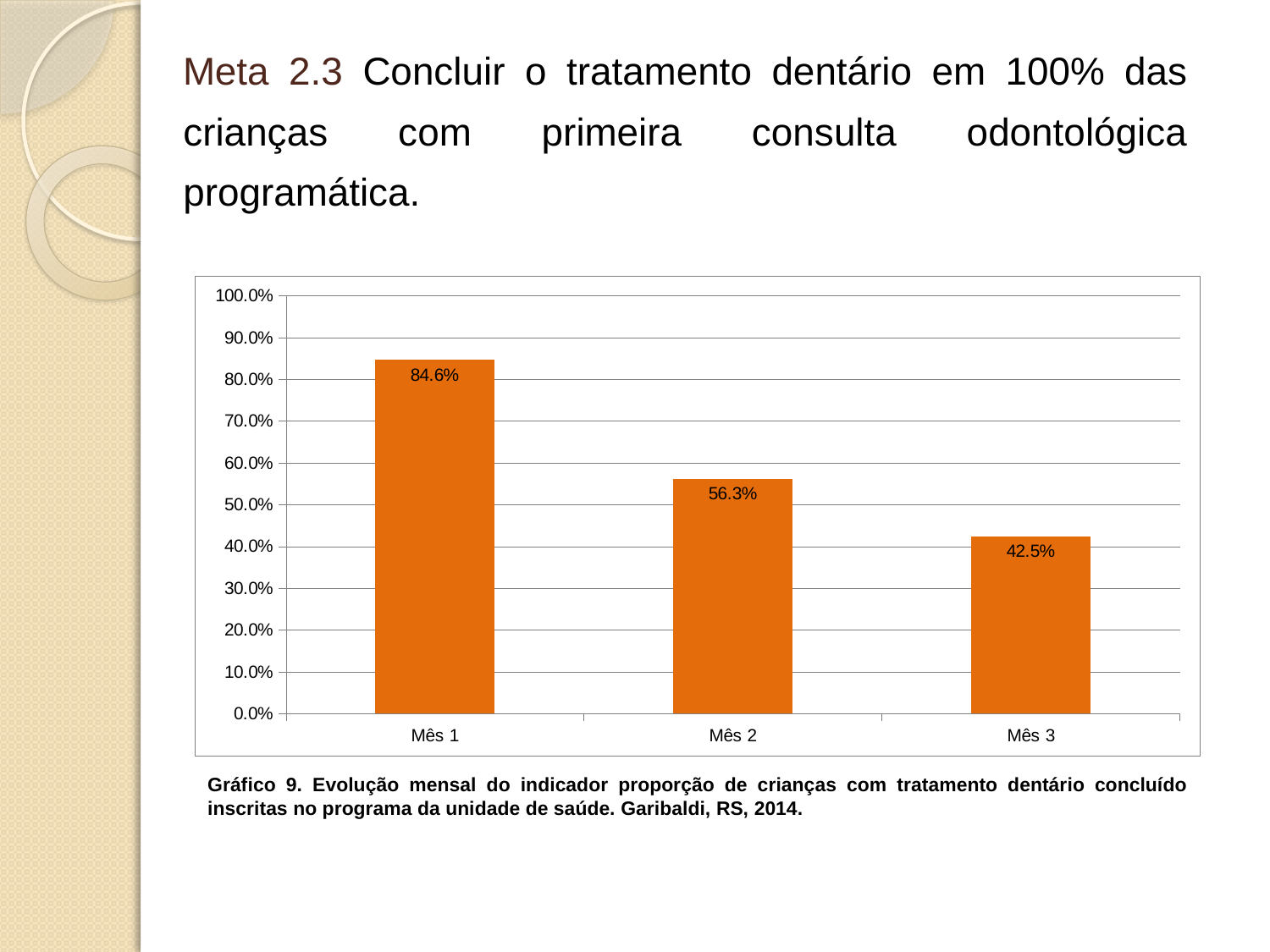
What is the value for Mês 1? 84.6% Is the value for Mês 2 greater or less than 50.0%? greater Do the values rise or fall from Mês 1 to Mês 3? Fall Which month has the highest value? Mês 1 Which month has the lowest value? Mês 3 What kind of chart is shown on the slide? Bar chart What is the difference between the values for Mês 2 and Mês 3? 13.8% What is the difference between the values for Mês 1 and Mês 3? 42.1% Which is larger, the value for Mês 2 or the value for Mês 3? Mês 2 What is the value for Mês 3? 42.5% How many months are shown on the x axis? 3 What is the value for Mês 2? 56.3%